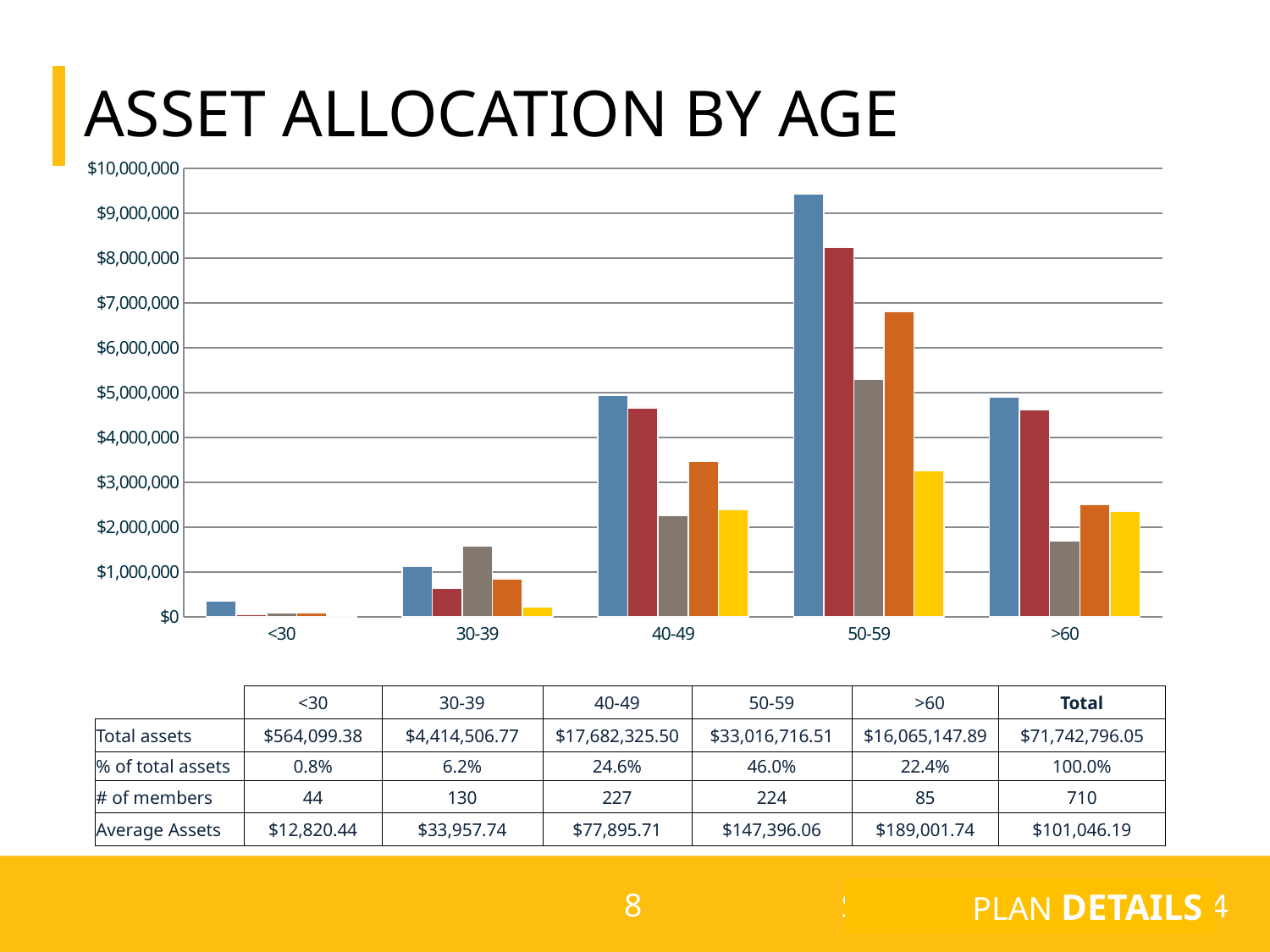
Do the blue bars rise or fall from the <30 group to the 50-59 group? rise Is the value of the gray bar for 30-39 greater or less than $1,000,000? greater How many age groups are shown on the x axis of the chart? 5 Which age group has the shortest bars overall in the chart? <30 What kind of chart is shown on the slide? bar chart What is the title of the chart? ASSET ALLOCATION BY AGE Which is larger: the blue bar for 50-59 or the blue bar for >60? the blue bar for 50-59 How many bars are plotted for each age group in the chart? 5 Is the value of the orange bar for 50-59 greater or less than $7,000,000? less Is the value of the blue bar for <30 greater or less than $1,000,000? less Which age group has the tallest blue bar in the chart? 50-59